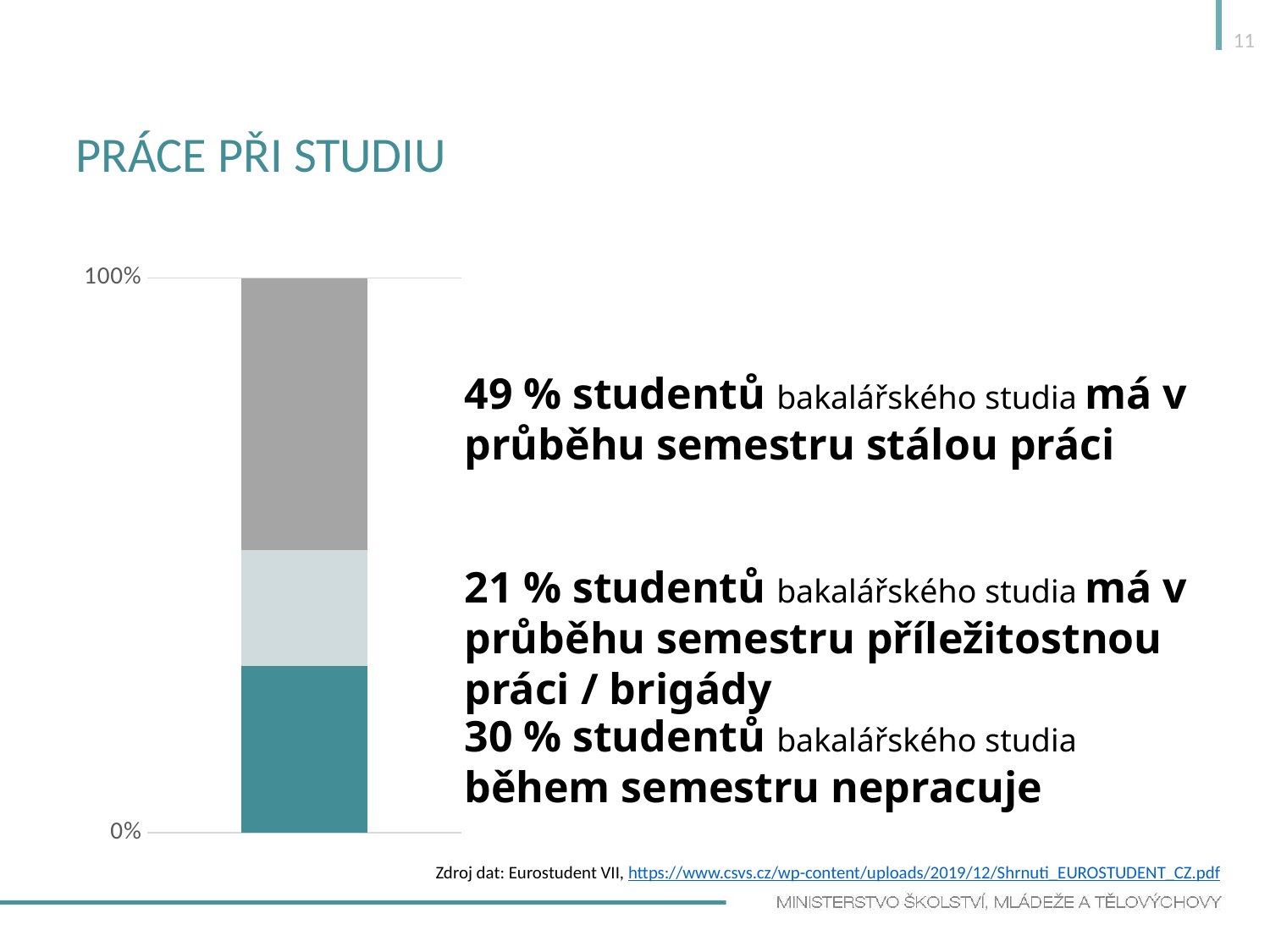
What is the difference between the share of bachelor students with a steady job (49 %) and the share with occasional work (21 %)? 28 % How many segments make up the stacked bar in the chart? 3 What do the three percentages on the slide (49 %, 21 %, 30 %) add up to? 100 % Which of the three segments of the stacked bar is the smallest: the top dark grey one, the middle light grey one, or the bottom teal one? the middle light grey one According to the slide, what percentage of bachelor students have occasional work / temporary jobs during the semester? 21 % What is the highest value shown on the vertical axis of the chart? 100% According to the slide, what percentage of bachelor students do not work during the semester? 30 % Which of the three segments of the stacked bar is the largest: the top dark grey one, the middle light grey one, or the bottom teal one? the top dark grey one According to the slide, what percentage of bachelor students have a steady job during the semester? 49 % Is the bottom teal segment of the stacked bar larger or smaller than the middle light grey segment? larger What kind of chart is shown on the slide? stacked bar chart What is the lowest value shown on the vertical axis of the chart? 0%